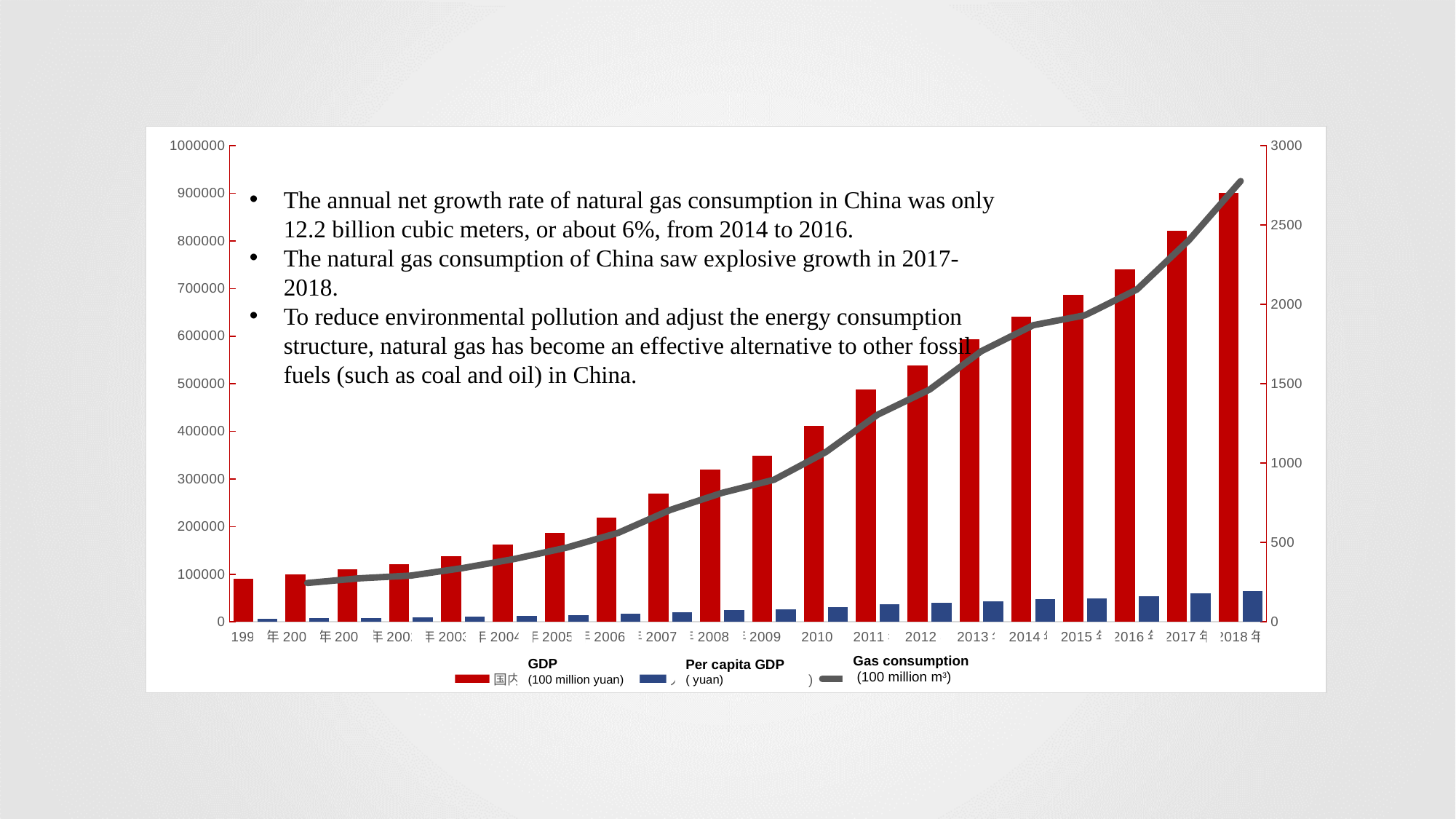
Is the GDP value for 2018 greater or less than 800000? greater Which series is plotted as a line rather than bars? Gas consumption (100 million m³) Is the GDP value for 2010 greater or less than 500000? less Is the gas consumption value for 2018 greater or less than 2500 on the right axis? greater Which year has the highest GDP bar? 2018 Does gas consumption rise or fall from 1999 to 2018? Rises Which year has the lowest GDP bar? 1999 What kind of chart is shown on the slide? A combined bar and line chart How many series does the legend list? 3 How many years are plotted along the x axis? 20 Which year has the larger GDP bar, 2016 or 2017? 2017